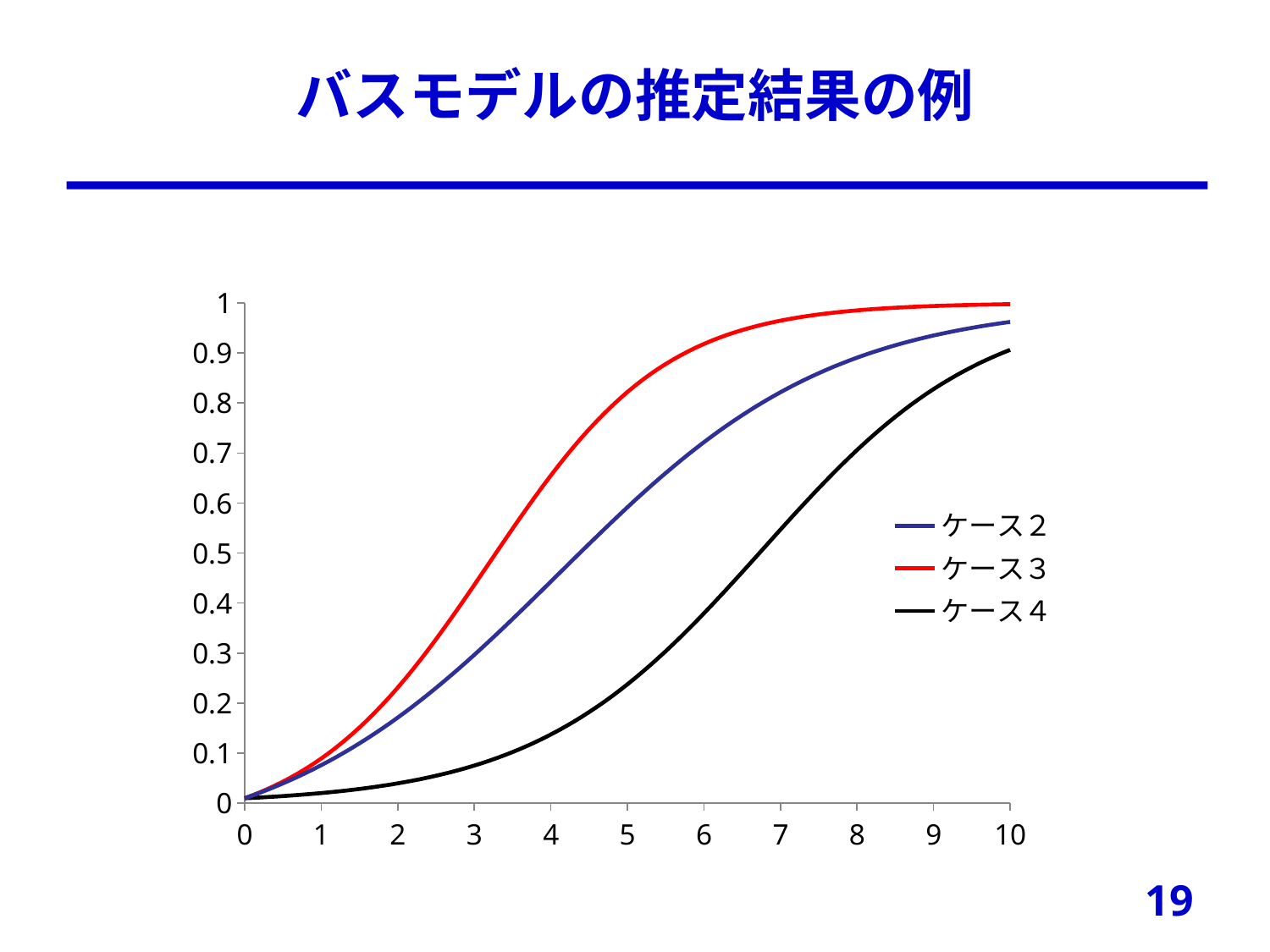
Is the value for ケース2 at x = 8 greater or less than 0.8? greater Which series is drawn in red? ケース3 How many tick labels are shown on the x axis? 11 What is the title of the slide containing the chart? バスモデルの推定結果の例 At x = 5, which is larger, the value for ケース3 or the value for ケース4? ケース3 Is the value for ケース4 at x = 4 greater or less than 0.2? less How many series does the legend list? 3 What kind of chart is shown on the slide? line chart Is the value for ケース3 at x = 4 greater or less than 0.6? greater Which series has the highest value at x = 10? ケース3 Do the values for ケース2 rise or fall as x increases from 0 to 10? rise Which series has the lowest value at x = 6? ケース4